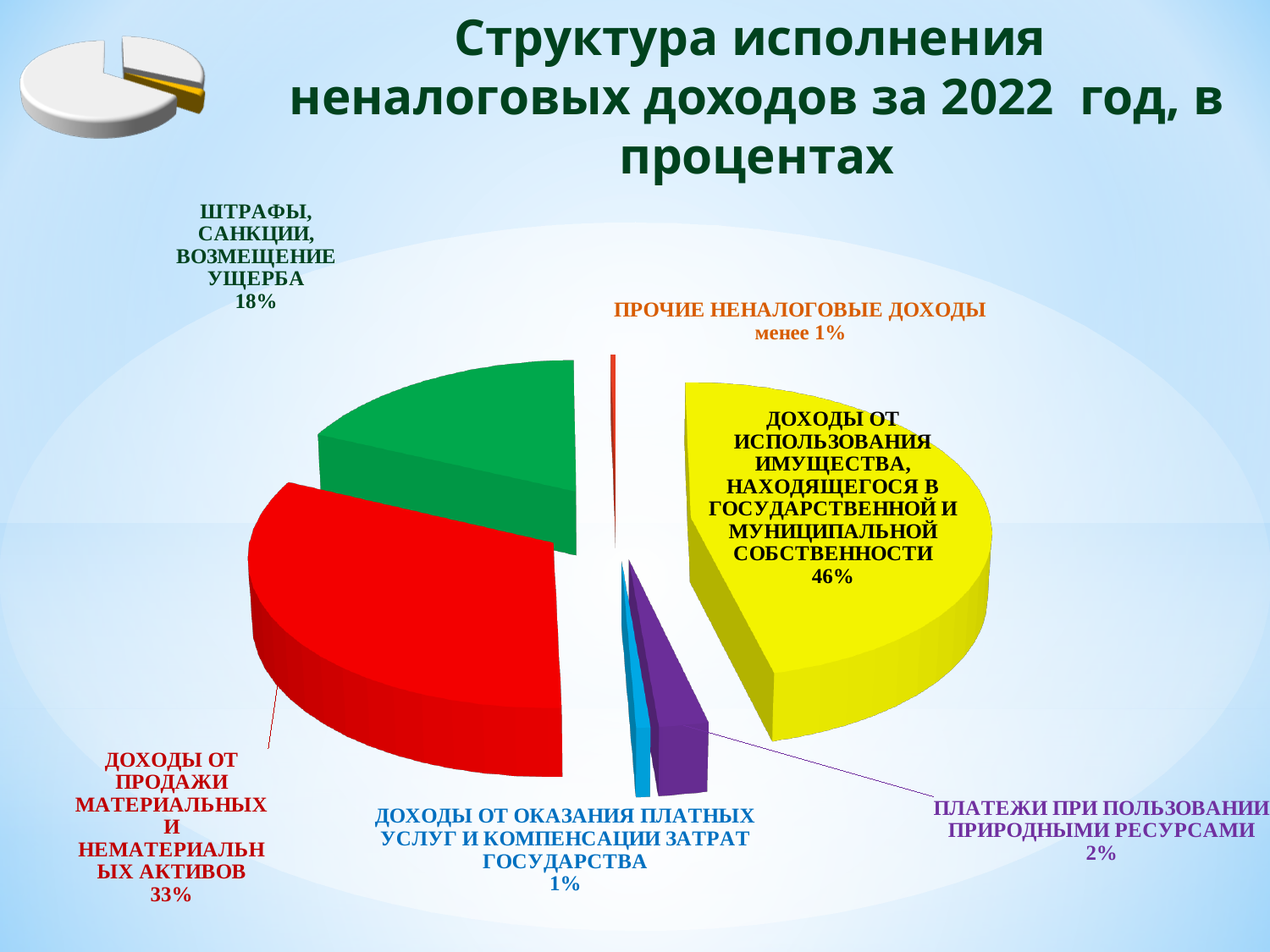
Какой тип диаграммы показан на слайде? Круговая диаграмма Какая категория имеет наибольшую долю на диаграмме? Доходы от использования имущества, находящегося в государственной и муниципальной собственности Какую долю составляют доходы от продажи материальных и нематериальных активов? 33% Какую долю составляют доходы от использования имущества, находящегося в государственной и муниципальной собственности? 46% Какую долю составляют штрафы, санкции, возмещение ущерба? 18% Какая доля указана для прочих неналоговых доходов? менее 1% Каким цветом показан сектор доходов от продажи материальных и нематериальных активов? Красным Сколько категорий показано на круговой диаграмме? 6 Что больше: доля штрафов, санкций, возмещения ущерба или доля платежей при пользовании природными ресурсами? Штрафы, санкции, возмещение ущерба На сколько процентных пунктов доля доходов от использования имущества больше доли доходов от продажи материальных и нематериальных активов? 13 Какую долю составляют доходы от оказания платных услуг и компенсации затрат государства? 1% Какую долю составляют платежи при пользовании природными ресурсами? 2%